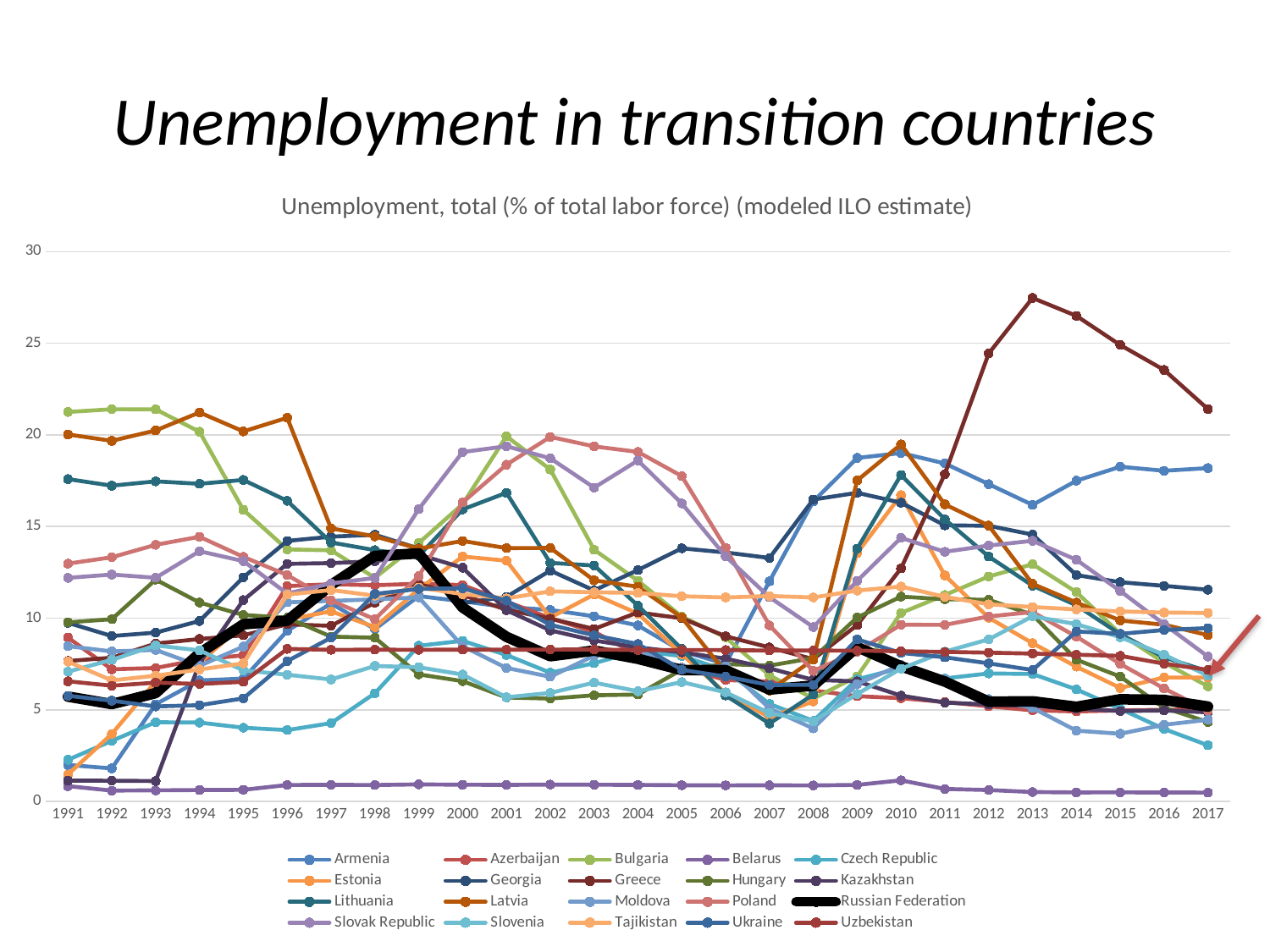
Is the value for Greece in 2013 greater or less than 25? greater In which year does the highest point on the chart occur? 2013 What kind of chart is shown on the slide? line chart Which series reaches the highest value anywhere on the chart? Greece What is the title printed above the chart area? Unemployment, total (% of total labor force) (modeled ILO estimate) How many years are shown along the x axis? 27 Does the value for Greece rise or fall from 2013 to 2017? fall Is the value for the Russian Federation in 2017 greater or less than 10? less How many series does the legend list? 20 Is the value for the Russian Federation in 1999 greater or less than 10? greater Which is larger for the Russian Federation, the value in 1999 or the value in 2017? 1999 Which series is drawn with a thick black line? Russian Federation